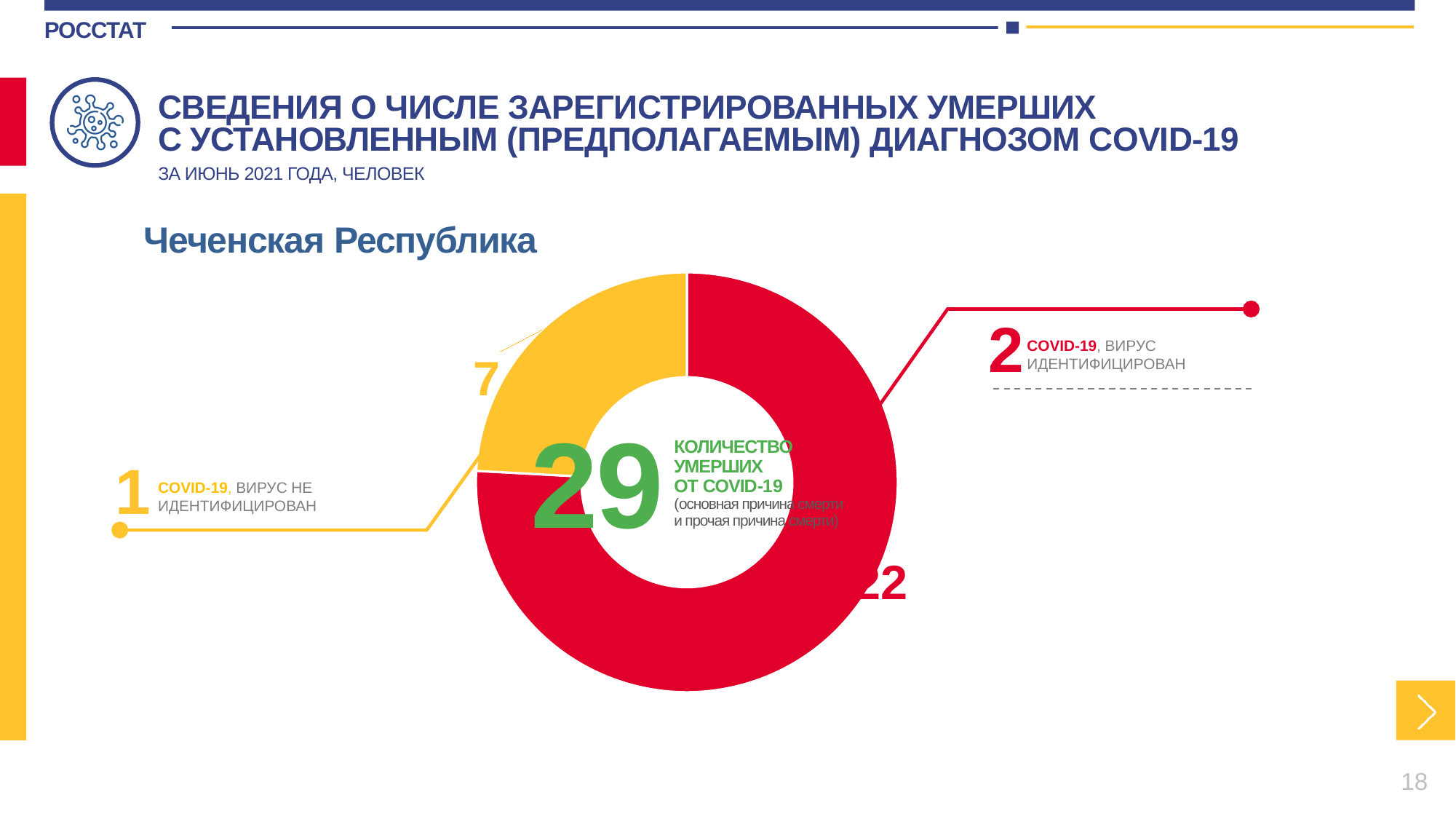
Which slice of the donut chart is the smallest? The yellow slice (7) Which slice of the donut chart is the largest? The red slice (22) What number is shown in the callout labelled 'COVID-19, вирус идентифицирован'? 2 What value is shown for the yellow slice of the donut chart? 7 What number is shown in the callout labelled 'COVID-19, вирус не идентифицирован'? 1 What value is shown for the red slice of the donut chart? 22 What kind of chart is shown on the slide for the Chechen Republic? Donut (pie) chart Which is larger, the red slice or the yellow slice? The red slice How many slices does the donut chart have? 2 Which region is the donut chart about? Чеченская Республика What total number of deaths from COVID-19 is shown in the centre of the donut chart? 29 What is the difference between the red slice value and the yellow slice value? 15